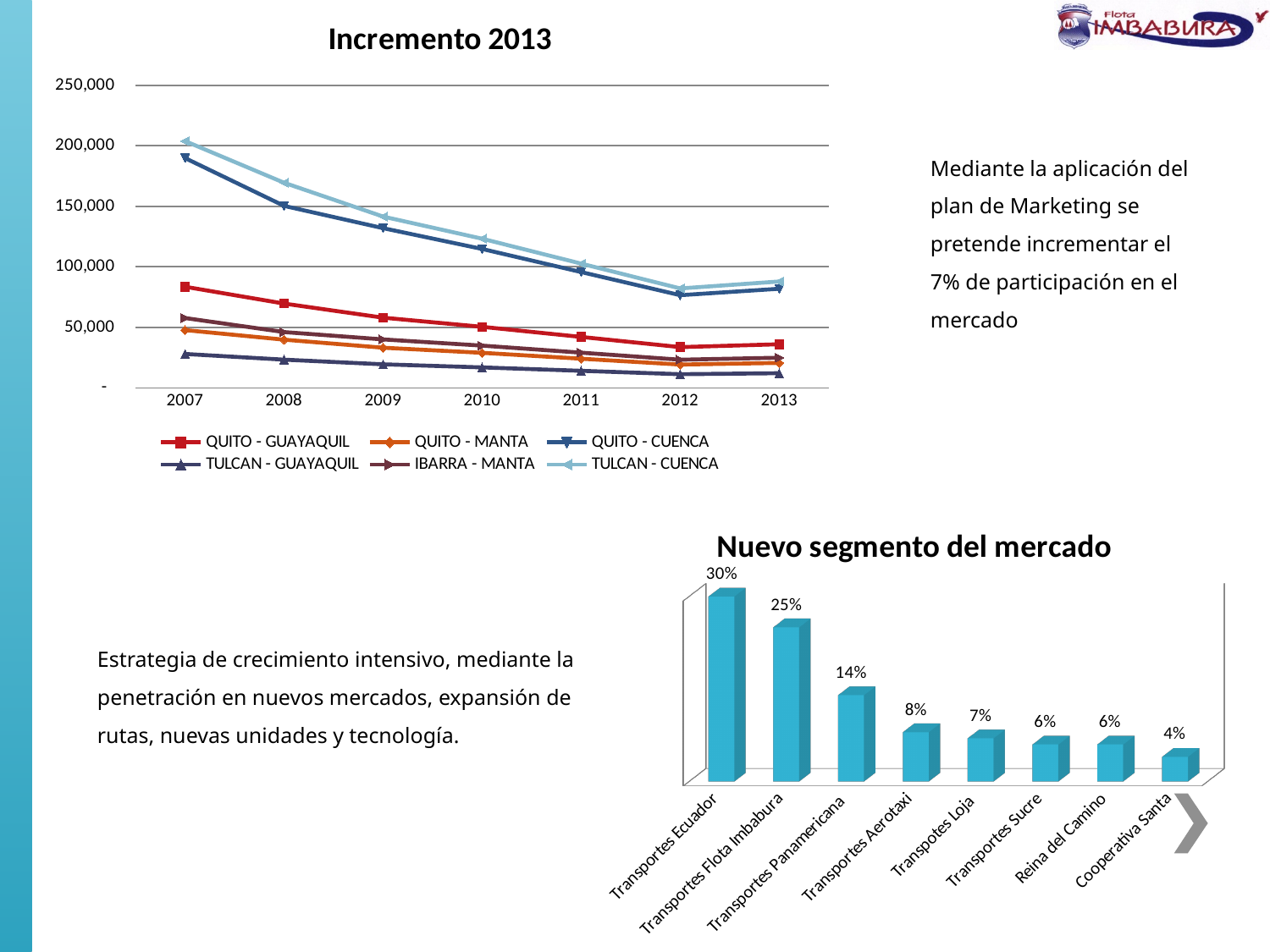
How many categories are shown in the 'Nuevo segmento del mercado' chart? 8 In the 'Nuevo segmento del mercado' chart, what is the difference between Transportes Ecuador and Transportes Flota Imbabura? 5% In the 'Nuevo segmento del mercado' chart, what is the value for Transportes Panamericana? 14% In the 'Incremento 2013' chart, which series has the lowest values across all years? TULCAN - GUAYAQUIL What kind of chart is 'Nuevo segmento del mercado'? Bar chart In the 'Nuevo segmento del mercado' chart, what is the value for Transportes Flota Imbabura? 25% In the 'Incremento 2013' chart, do the values for QUITO - CUENCA generally rise or fall from 2007 to 2012? Fall In the 'Incremento 2013' chart, is the value for QUITO - CUENCA in 2007 greater or less than 150,000? greater In the 'Nuevo segmento del mercado' chart, which is larger: Transportes Aerotaxi or Transpotes Loja? Transportes Aerotaxi In the 'Nuevo segmento del mercado' chart, which category has the lowest value? Cooperativa Santa In the 'Nuevo segmento del mercado' chart, which category has the highest value? Transportes Ecuador How many series does the legend of the 'Incremento 2013' chart list? 6